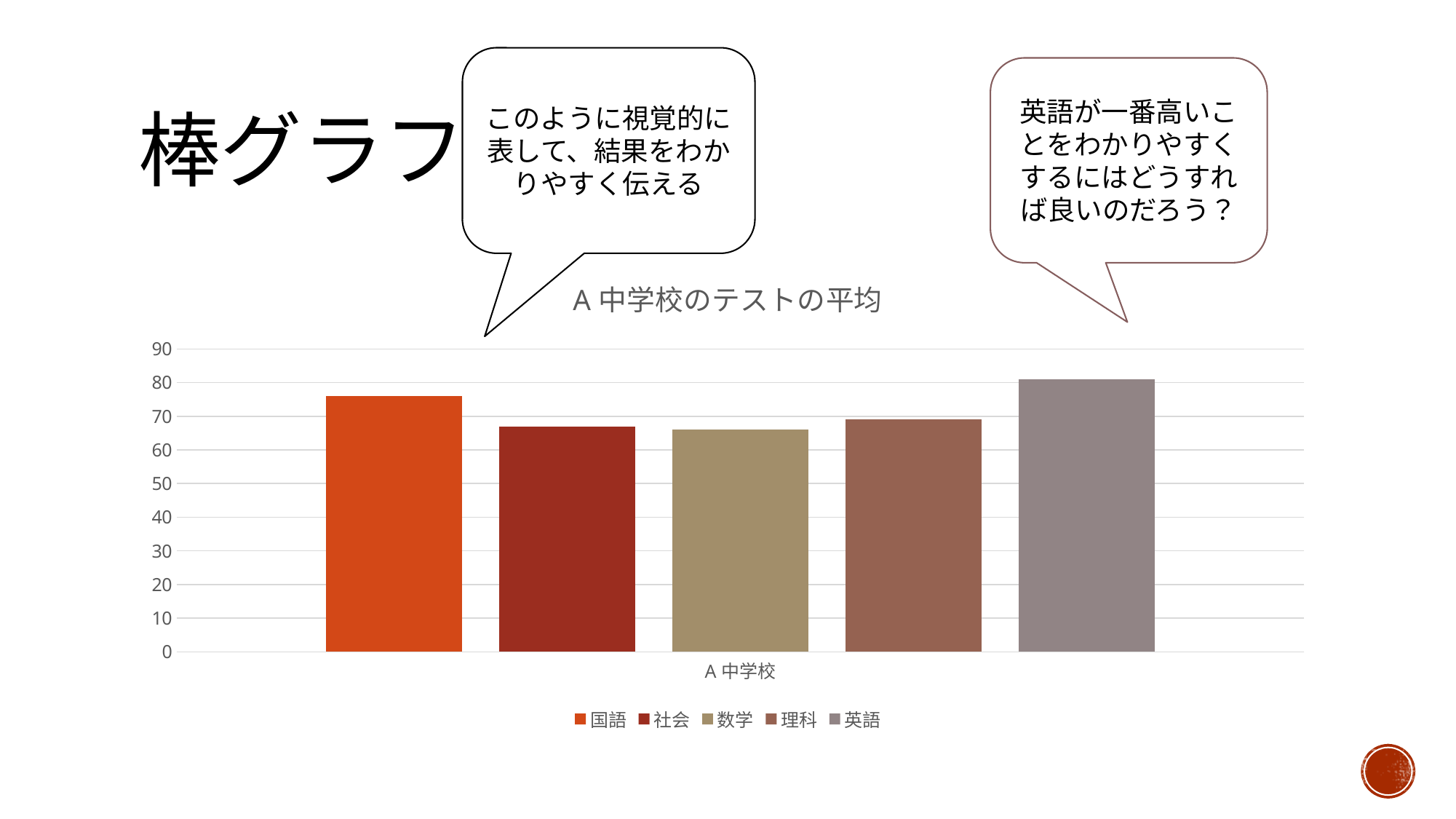
What kind of chart is shown on the slide? bar chart What is the category label shown on the x axis? A 中学校 What is the title of the chart? A 中学校のテストの平均 Is the value for 数学 greater or less than 70? less Which is larger, the value for 国語 or the value for 社会? 国語 Is the value for 国語 greater or less than 70? greater How many series does the legend list? 5 Is the value for 英語 greater or less than 70? greater Which series has the highest bar in the chart? 英語 Which is larger, the value for 英語 or the value for 国語? 英語